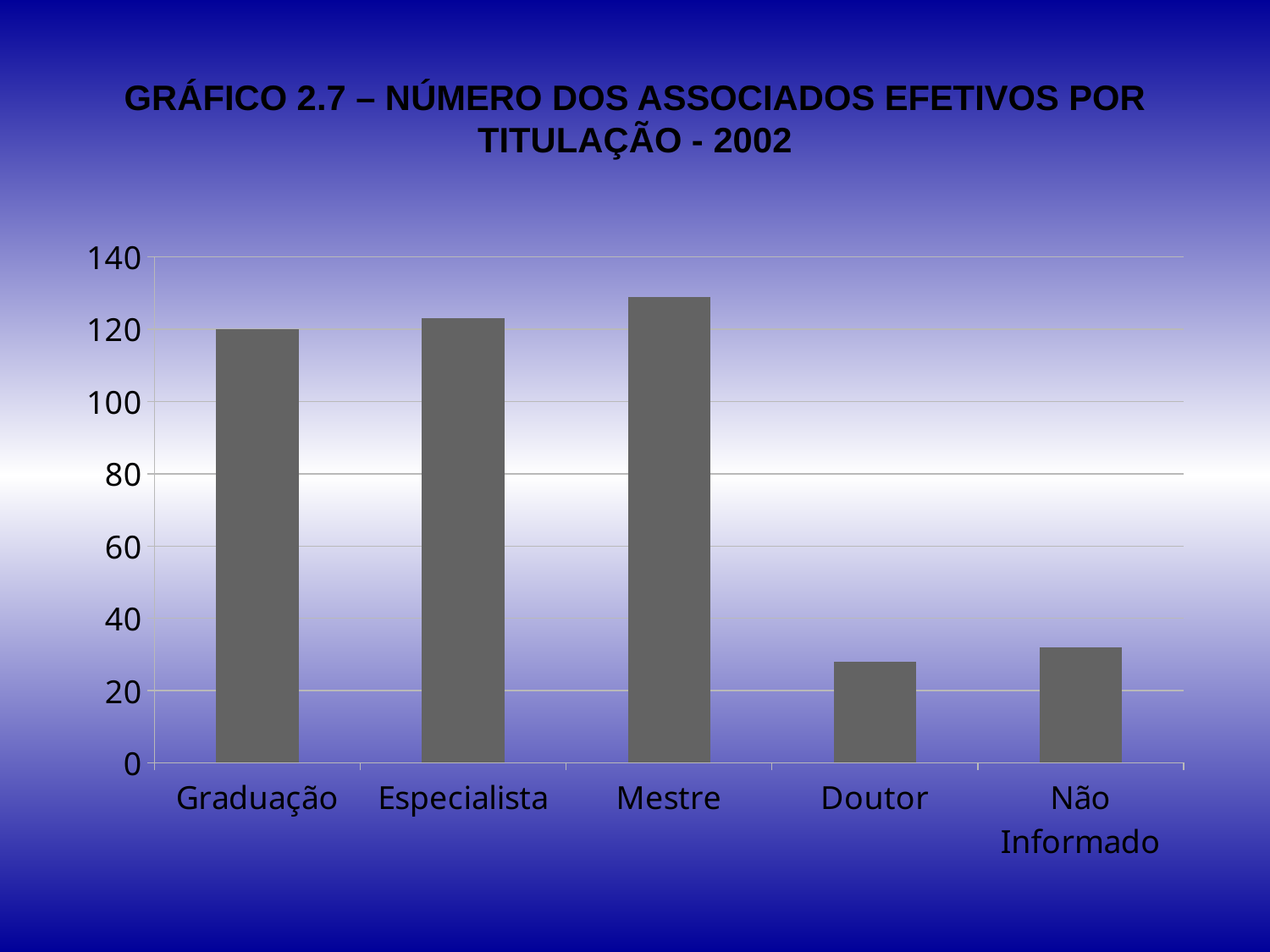
Which is larger, the value for Não Informado or the value for Doutor? Não Informado Is the value for Mestre greater or less than 120? greater Which is larger, the value for Especialista or the value for Doutor? Especialista Which category has the highest value in the chart? Mestre What is the value for Graduação? 120 Is the value for Especialista greater or less than 140? less Is the value for Doutor greater or less than 40? less Which category has the lowest value in the chart? Doutor How many categories are shown on the x axis of the chart? 5 What kind of chart is shown on the slide? bar chart What year is referenced in the chart title? 2002